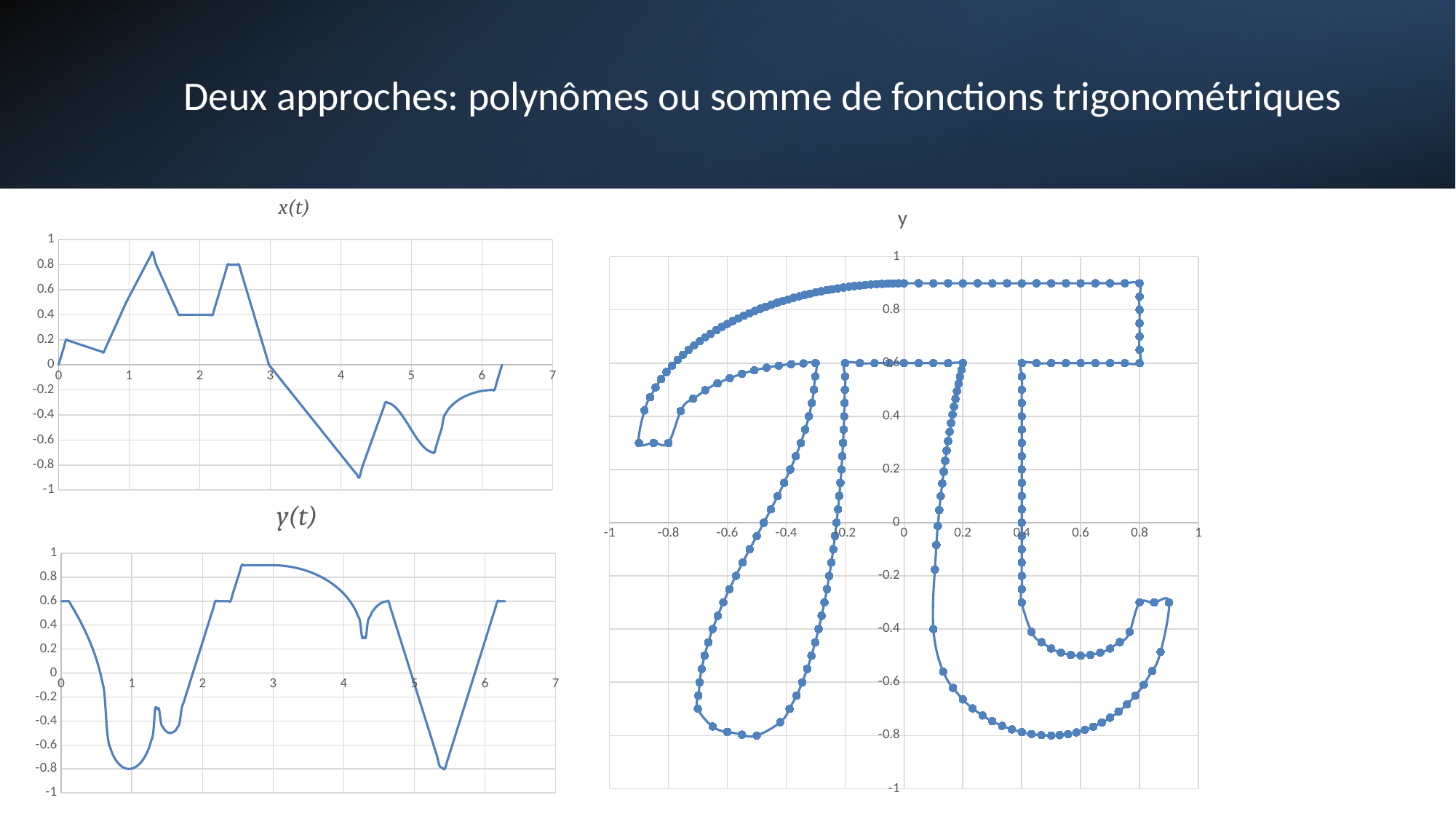
What kind of chart is the large chart on the right titled y? scatter chart In the x(t) chart, is the value at t = 4 greater or less than -0.4? less What kind of chart is the top-left chart titled x(t)? line chart In the y(t) chart, does the curve rise or fall between t = 5.5 and t = 6? rise In the y(t) chart, is the value at t = 1 greater or less than -0.6? less In the x(t) chart, does the curve rise or fall between t = 3 and t = 4? fall What is the title of the bottom-left chart? y(t) In the y(t) chart, is the value at t = 3 greater or less than 0.8? greater In the y(t) chart, what is the lowest value the curve reaches? -0.8 What is the title of the chart on the right side of the slide? y How many charts are shown on the slide? 3